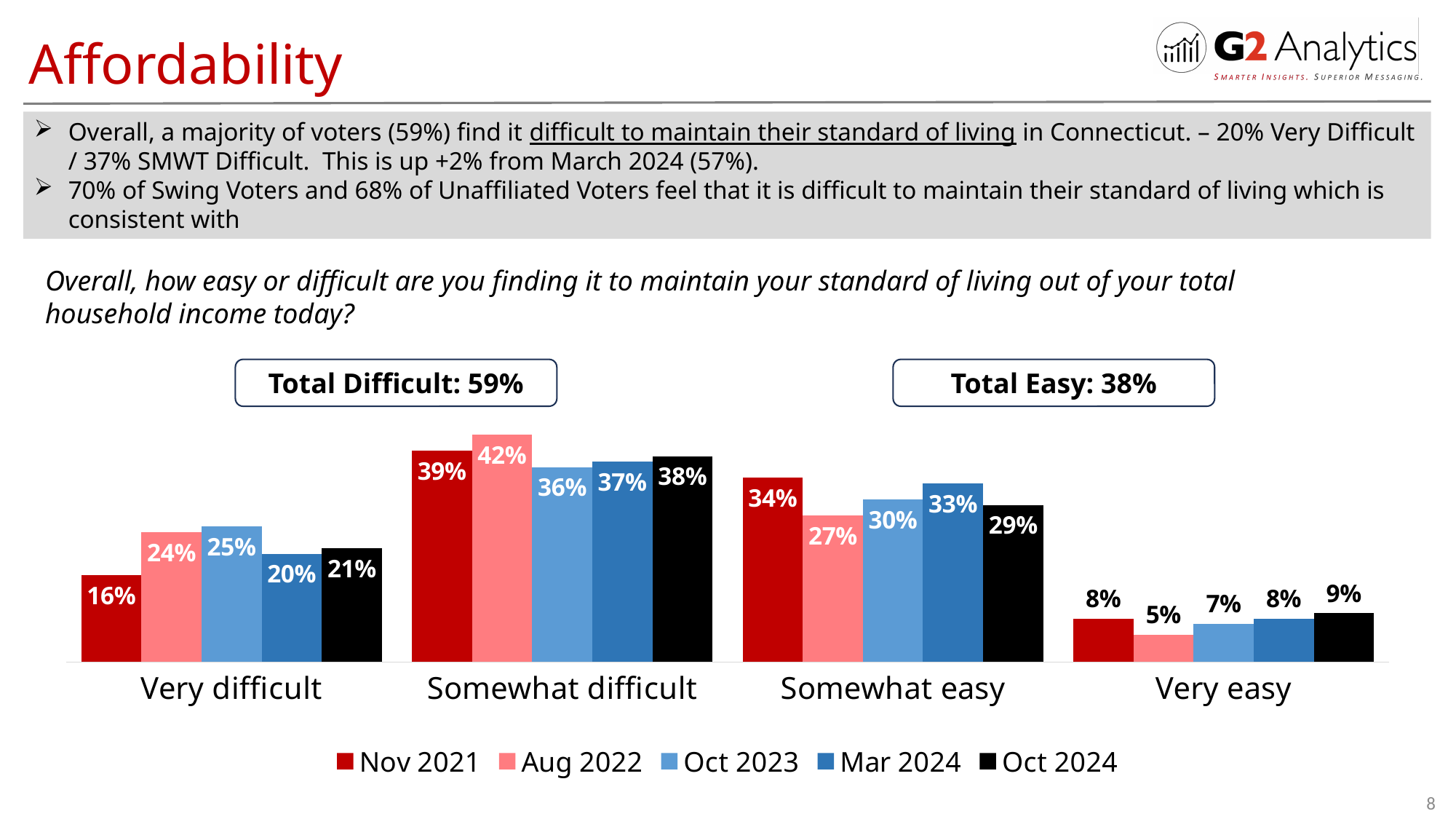
What kind of chart is shown on the slide? Bar chart What is the Total Difficult figure shown in the box above the chart? 59% How many categories are shown on the x axis? 4 What is the value for Oct 2024 in the Somewhat difficult category? 38% Which series has the lowest value in the Very easy category? Aug 2022 What is the value for Aug 2022 in the Somewhat easy category? 27% Which series has the highest value in the Somewhat difficult category? Aug 2022 Which is larger in the Somewhat easy category: Nov 2021 or Mar 2024? Nov 2021 What is the difference between the Oct 2024 and Nov 2021 values in the Very difficult category? 5% What is the value for Nov 2021 in the Very difficult category? 16% How many series does the legend list? 5 What colour represents the Oct 2024 series in the legend? Black